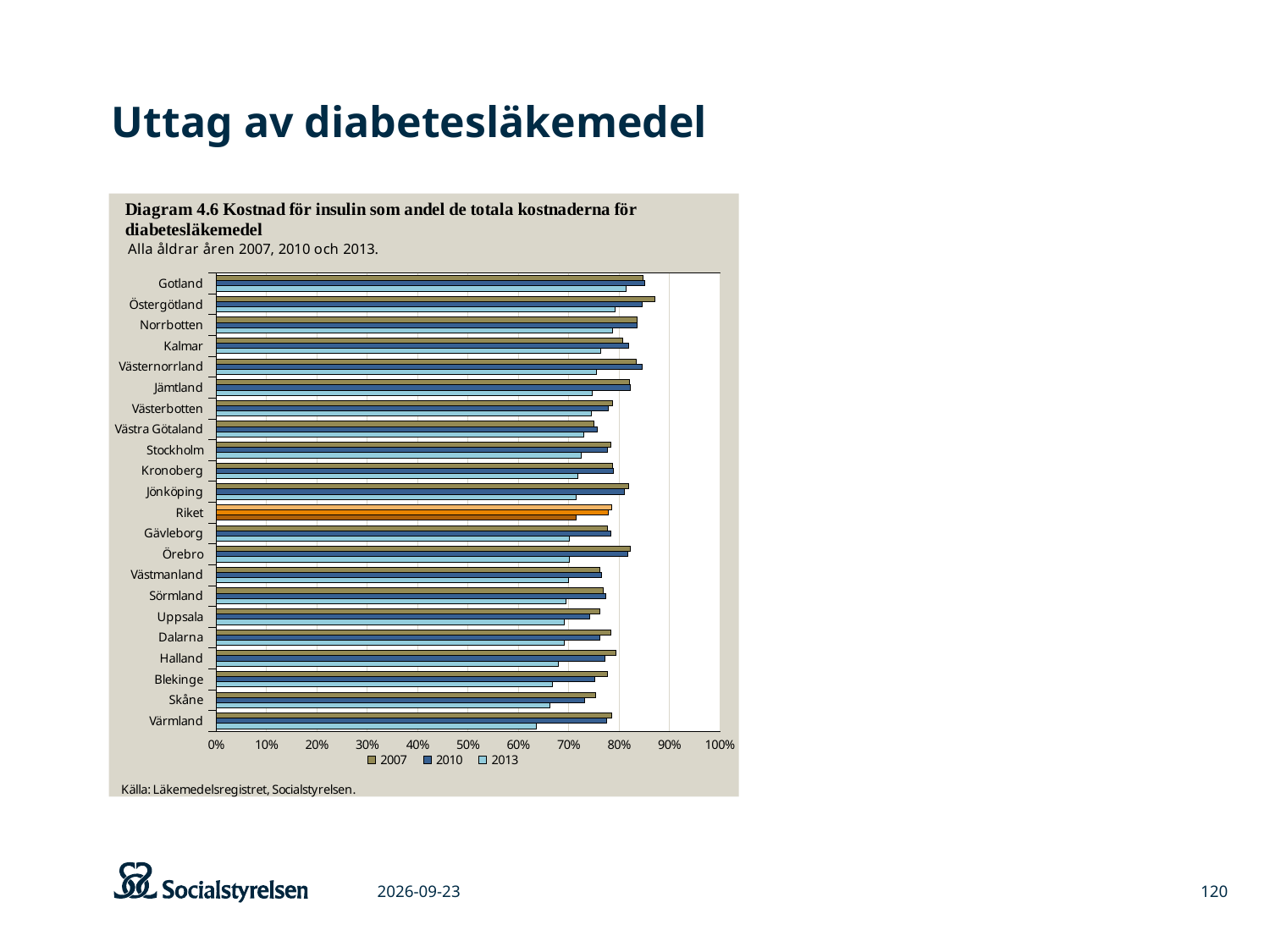
Which years are listed in the legend? 2007, 2010, 2013 Which region has the highest value for 2007? Östergötland Which region has the highest value for 2013? Gotland How many categories (regions including Riket) are shown on the y axis? 22 Which region has the lowest value for 2013? Värmland Is the 2013 value for Gotland greater or less than 80%? greater Which category is highlighted in orange? Riket Which is larger, the 2013 value for Gotland or the 2013 value for Värmland? Gotland Is the 2013 value for Värmland greater or less than 70%? less What kind of chart is shown on the slide? Bar chart How many series does the legend list? 3 For Värmland, do the values rise or fall from 2007 to 2013? fall